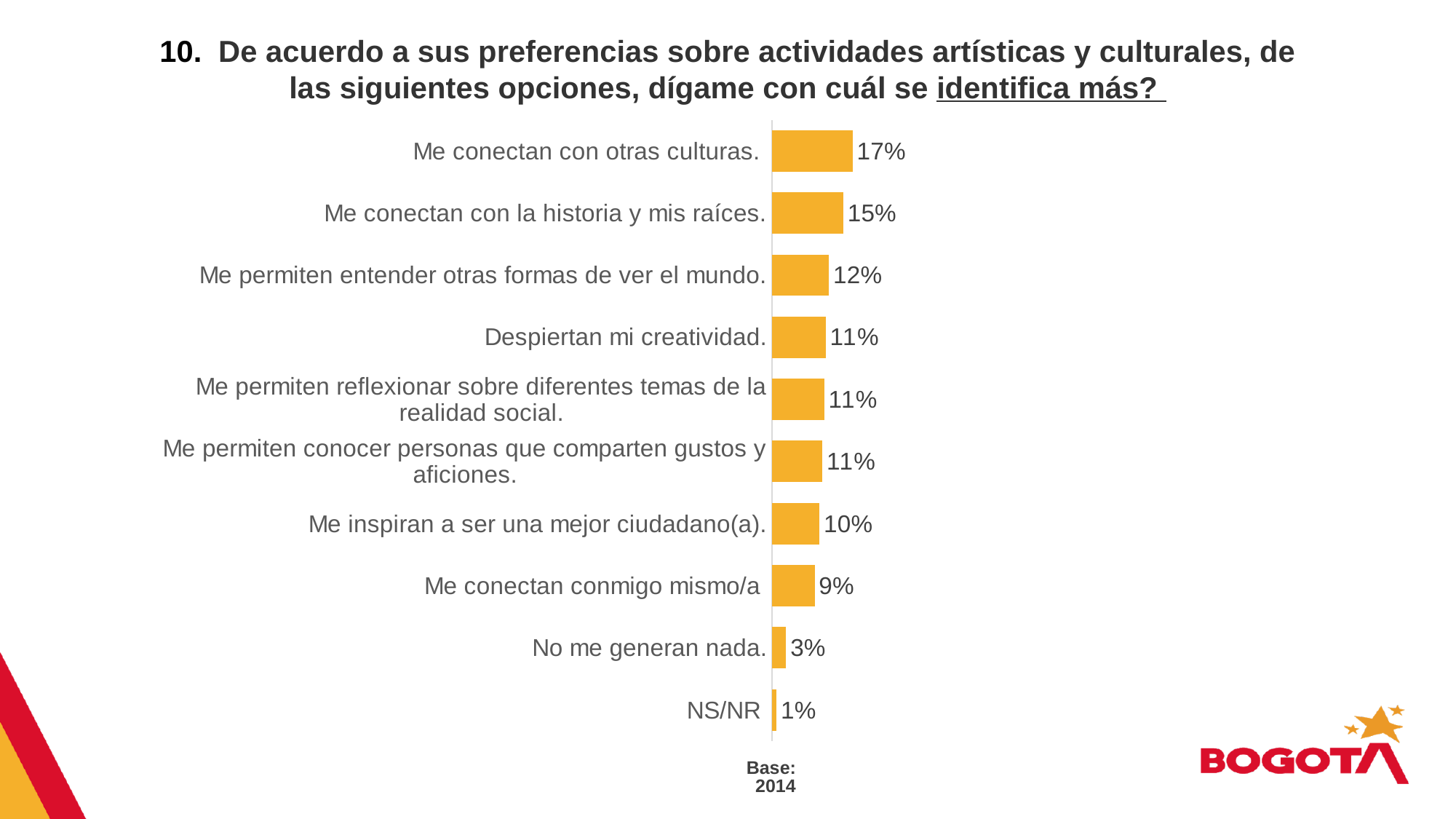
What is the difference between "Me conectan con otras culturas." and "Me conectan con la historia y mis raíces."? 2% What base (number of respondents) is indicated below the chart? 2014 Which option has the highest percentage? Me conectan con otras culturas. What percentage is shown for "Me conectan conmigo mismo/a"? 9% What type of chart is shown on the slide? Bar chart Which category has the lowest value? NS/NR What percentage of respondents chose "Me conectan con otras culturas."? 17% Which is larger: the value for "Despiertan mi creatividad." or the value for "Me conectan conmigo mismo/a"? Despiertan mi creatividad. What is the value shown for "Me conectan con la historia y mis raíces."? 15% What is the difference between "Me permiten entender otras formas de ver el mundo." and "Me inspiran a ser una mejor ciudadano(a)."? 2% What is the value for "No me generan nada."? 3% How many categories are shown in the chart? 10